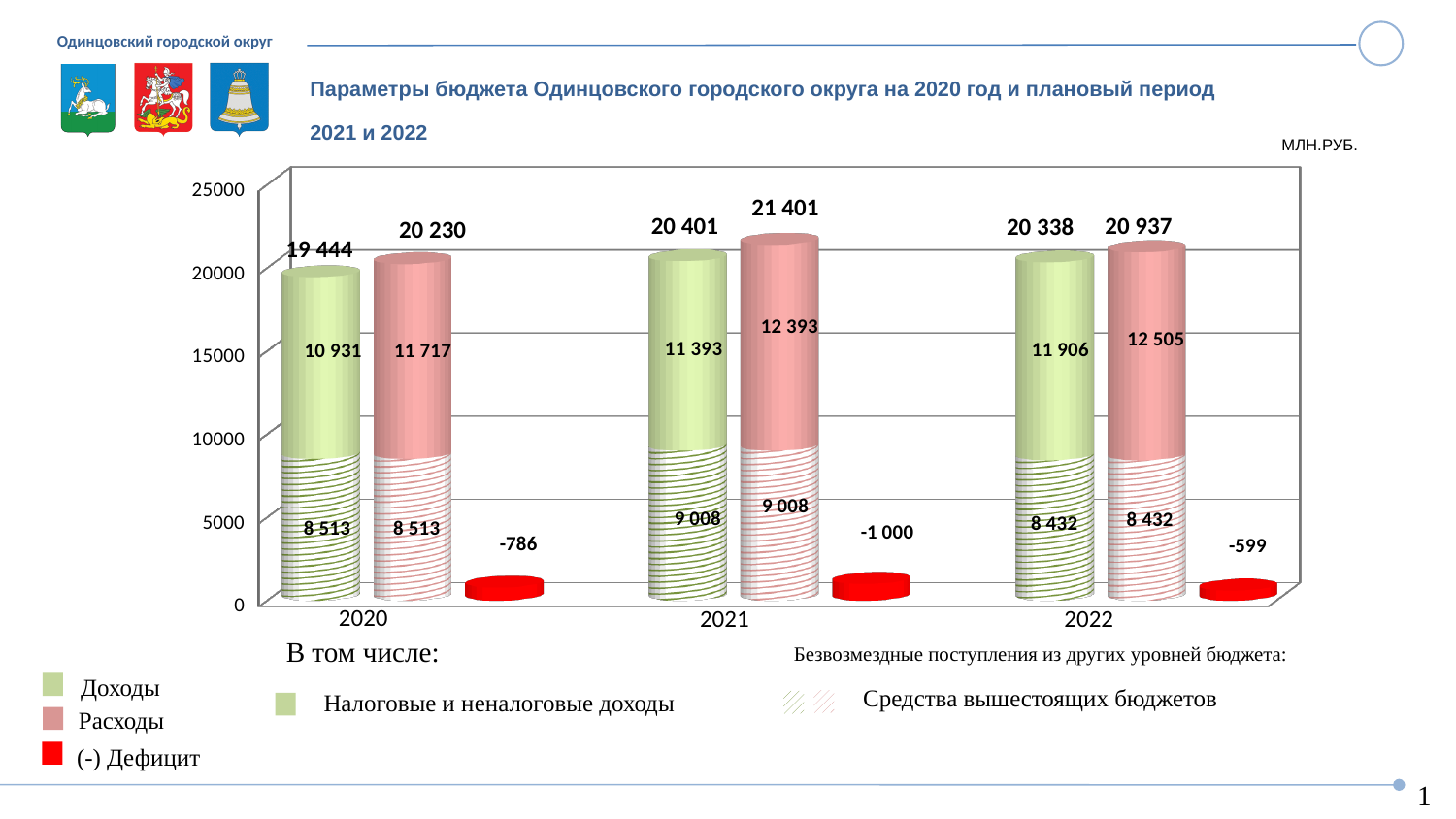
What is the difference between total expenditure and total income in 2020? 786 Which is larger in 2022: total income (Доходы) or total expenditure (Расходы)? Расходы In which year is the total expenditure (Расходы) the highest? 2021 In which year is the total income (Доходы) the lowest? 2020 What is the total income (Доходы) shown for 2021? 20 401 What is the deficit (Дефицит) value shown for 2020? -786 What unit of measurement is indicated for the chart values? МЛН.РУБ. What is the value of funds from higher-level budgets (Средства вышестоящих бюджетов) for 2021? 9 008 What is the total expenditure (Расходы) shown for 2022? 20 937 What type of chart is shown on the slide? bar chart How many years are shown on the x axis of the chart? 3 What is the value of tax and non-tax income (Налоговые и неналоговые доходы) for 2022? 11 906